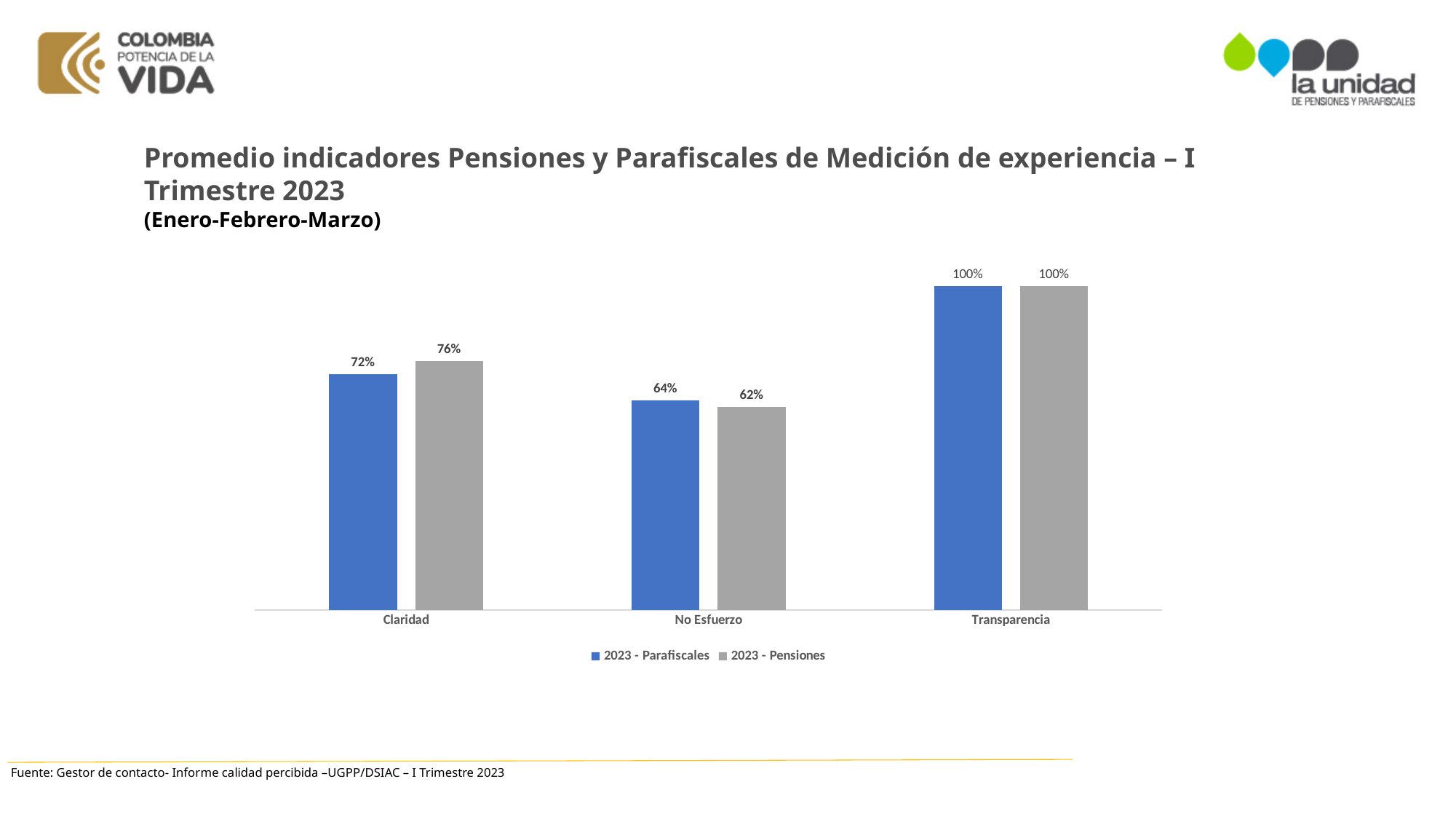
Which category has the lowest value in the 2023 - Pensiones series? No Esfuerzo What is the value for No Esfuerzo in the 2023 - Pensiones series? 62% What kind of chart is shown on the slide? Bar chart How many series does the legend list? 2 For No Esfuerzo, which series has the larger value, 2023 - Parafiscales or 2023 - Pensiones? 2023 - Parafiscales What is the value for Transparencia in the 2023 - Pensiones series? 100% What is the difference between the 2023 - Pensiones and 2023 - Parafiscales values for Claridad? 4% What is the value for Claridad in the 2023 - Pensiones series? 76% What is the value for No Esfuerzo in the 2023 - Parafiscales series? 64% How many categories are shown on the x axis? 3 Which category has the highest value in the 2023 - Parafiscales series? Transparencia What is the value for Claridad in the 2023 - Parafiscales series? 72%